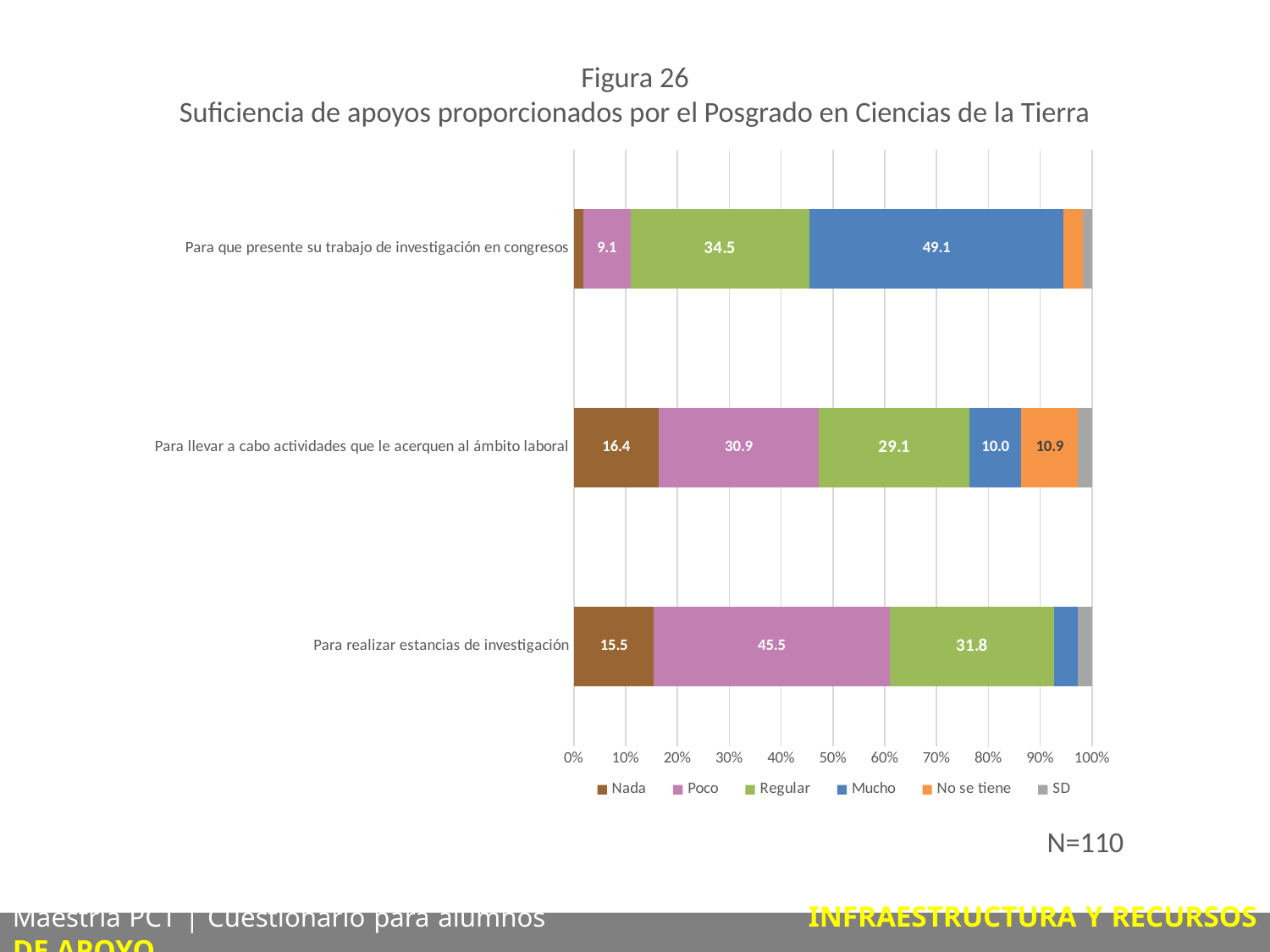
Which category has the highest value for "Regular"? Para que presente su trabajo de investigación en congresos What is the value of "Poco" for "Para realizar estancias de investigación"? 45.5 What is the difference between the "Poco" values for "Para realizar estancias de investigación" and "Para llevar a cabo actividades que le acerquen al ámbito laboral"? 14.6 Which is larger: the "Regular" value for "Para realizar estancias de investigación" or for "Para llevar a cabo actividades que le acerquen al ámbito laboral"? Para realizar estancias de investigación What is the value of "No se tiene" for "Para llevar a cabo actividades que le acerquen al ámbito laboral"? 10.9 How many categories (bars) are plotted in the chart? 3 How many series does the legend list? 6 What is the value of "Mucho" for "Para que presente su trabajo de investigación en congresos"? 49.1 Which category has the lowest value for "Poco"? Para que presente su trabajo de investigación en congresos What type of chart is shown on the slide? Stacked bar chart What is the value of "Nada" for "Para llevar a cabo actividades que le acerquen al ámbito laboral"? 16.4 What is the sample size (N) stated on the slide? N=110